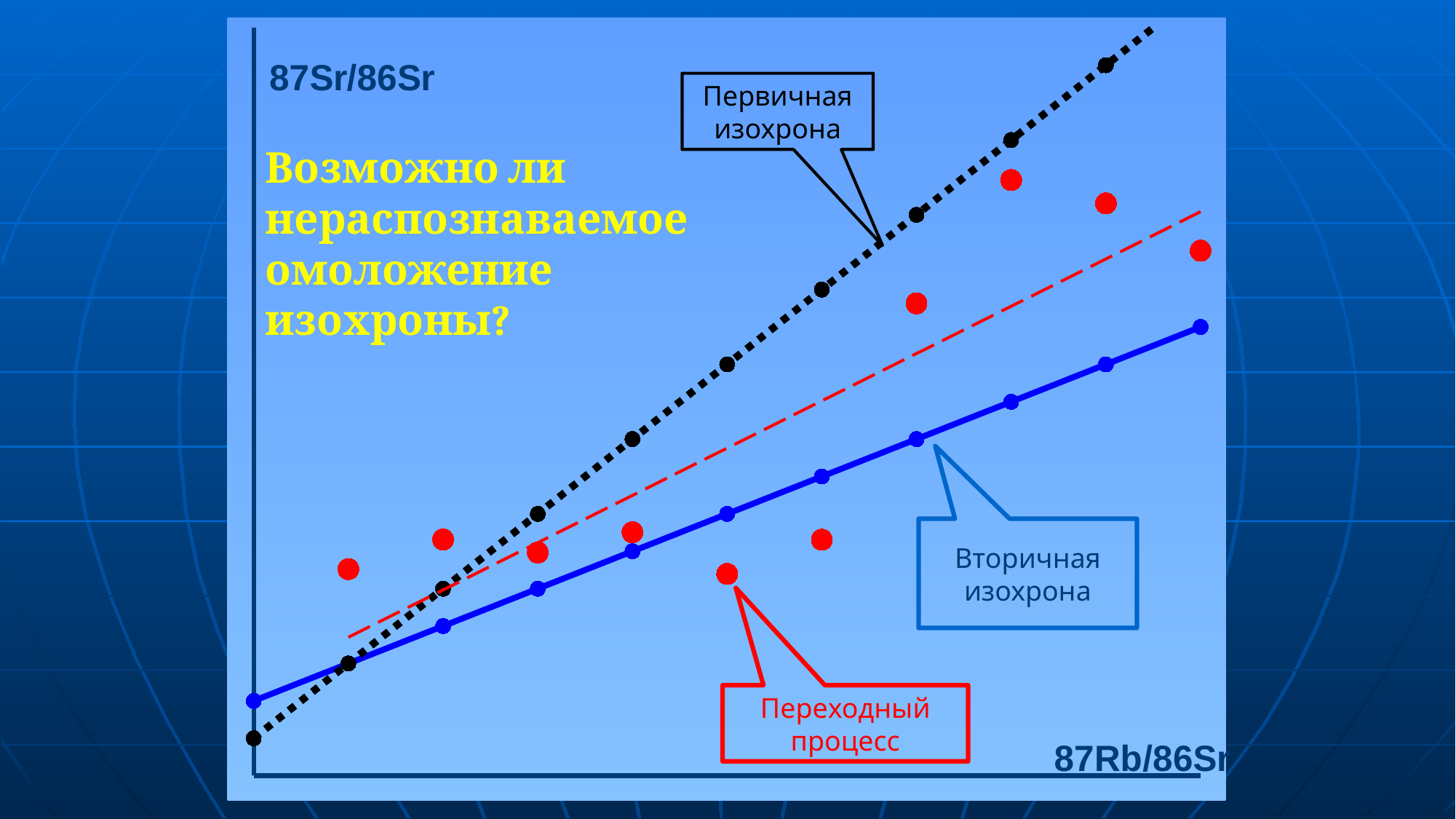
What kind of chart is shown on the slide? scatter chart with fitted lines How many red points labelled 'Переходный процесс' are plotted? 10 Which labelled series is drawn as a dotted black line? Первичная изохрона What is the label of the vertical axis? 87Sr/86Sr At the right-hand end of the chart, which line reaches the higher 87Sr/86Sr value, 'Первичная изохрона' or 'Вторичная изохрона'? Первичная изохрона How many labelled groups of points (series) are shown on the chart? 3 Which line has the steeper slope, 'Первичная изохрона' or 'Вторичная изохрона'? Первичная изохрона Do the values along the line labelled 'Первичная изохрона' rise or fall as 87Rb/86Sr increases? rise How many blue points lie on the 'Вторичная изохрона' line? 10 Do the values along the line labelled 'Вторичная изохрона' rise or fall as 87Rb/86Sr increases? rise What is the label of the horizontal axis? 87Rb/86Sr How many black points lie on the 'Первичная изохрона' line? 10